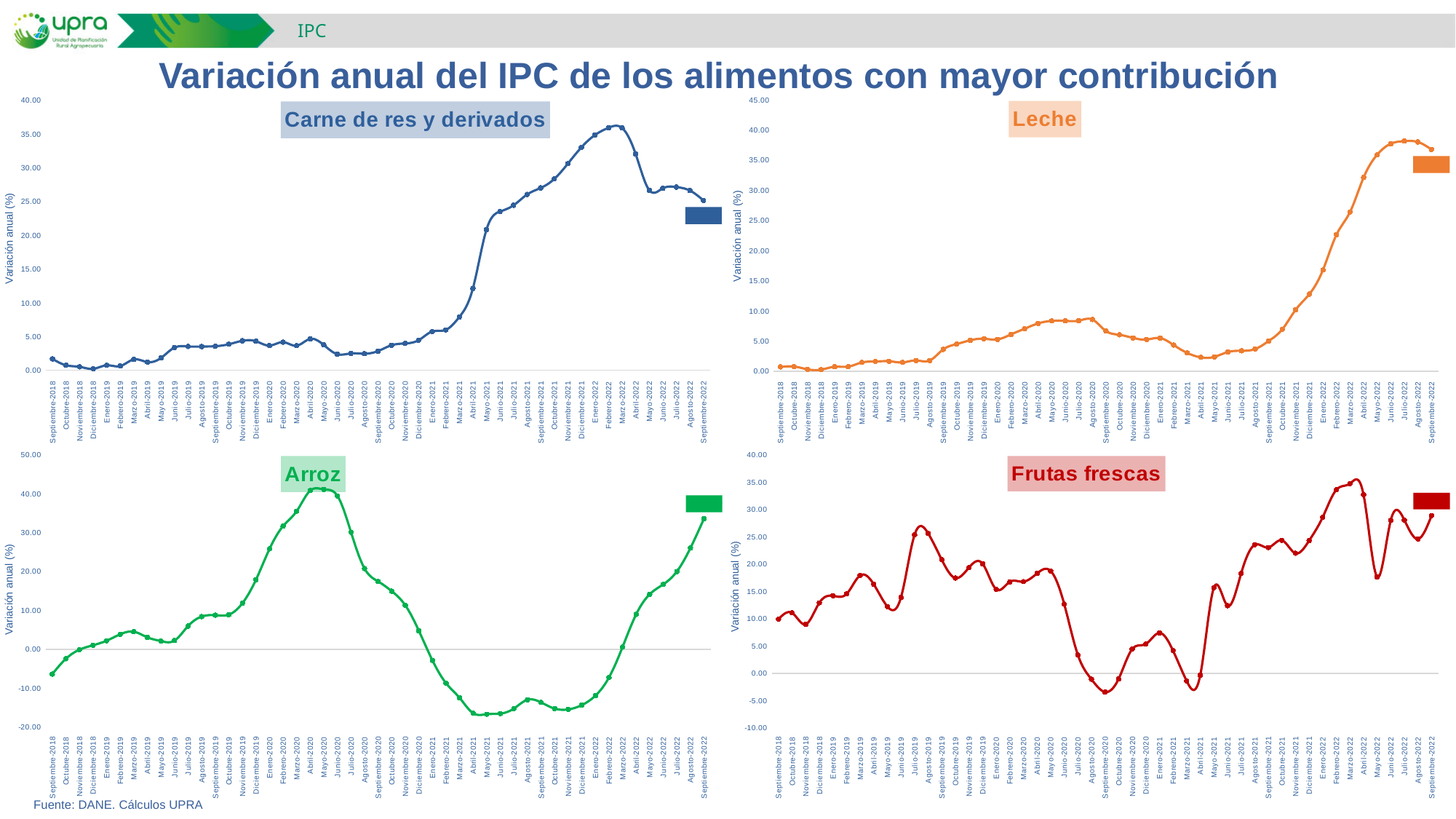
In the 'Leche' chart, is the value for Septiembre-2022 greater or less than 35.00? greater In the 'Frutas frescas' chart, is the value for Septiembre-2022 greater or less than 25.00? greater What kind of chart is used for the four panels on this slide? Line chart What source is cited at the bottom of the slide? Fuente: DANE. Cálculos UPRA How many charts are shown on the slide? 4 In the 'Carne de res y derivados' chart, do values rise or fall from Marzo-2022 to Septiembre-2022? fall In the 'Carne de res y derivados' chart, is the value for Diciembre-2018 greater or less than 5.00? less What is the main title of the slide? Variación anual del IPC de los alimentos con mayor contribución Which is larger for Septiembre-2022: the value in the 'Leche' chart or the value in the 'Carne de res y derivados' chart? Leche In the 'Leche' chart, do values rise or fall from Septiembre-2021 to Julio-2022? rise